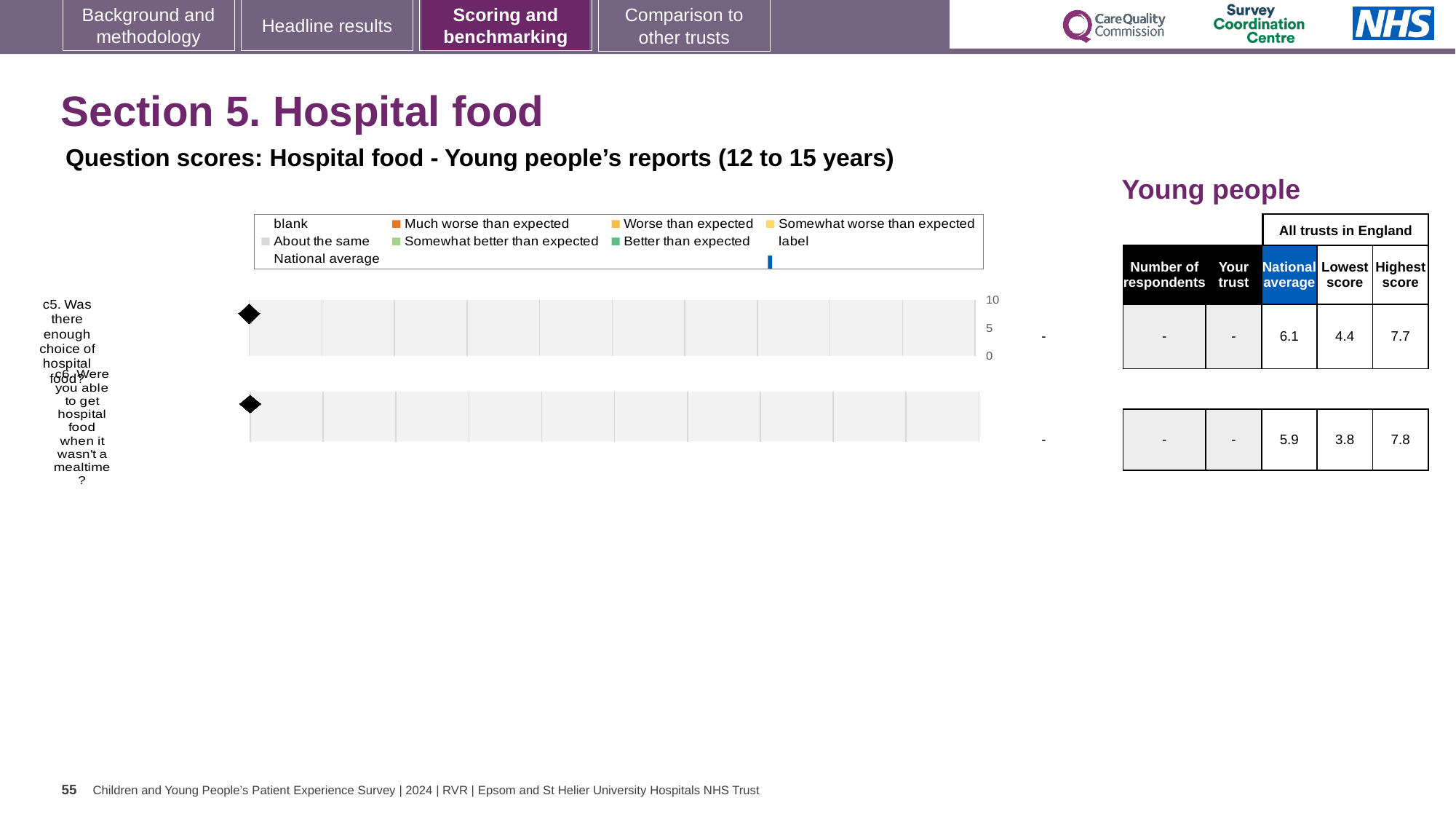
In the table next to the chart, what is the difference between the Highest score and Lowest score for c5? 3.3 In the table next to the chart, what is the Lowest score for c5? 4.4 In the table next to the chart, what is the Highest score for c6? 7.8 In the table next to the chart, what is the difference between the Highest score and Lowest score for c6? 4.0 What kind of chart is shown on the slide? bar chart In the table next to the chart, what is the National average score for c6 (able to get hospital food when it wasn't a mealtime)? 5.9 How many question categories are shown on the chart? 2 What is the highest value shown on the chart's axis? 10 In the table next to the chart, which question has the higher National average, c5 or c6? c5 What is the label of the first category on the chart? c5. Was there enough choice of hospital food? In the table next to the chart, what is the National average score for c5 (enough choice of hospital food)? 6.1